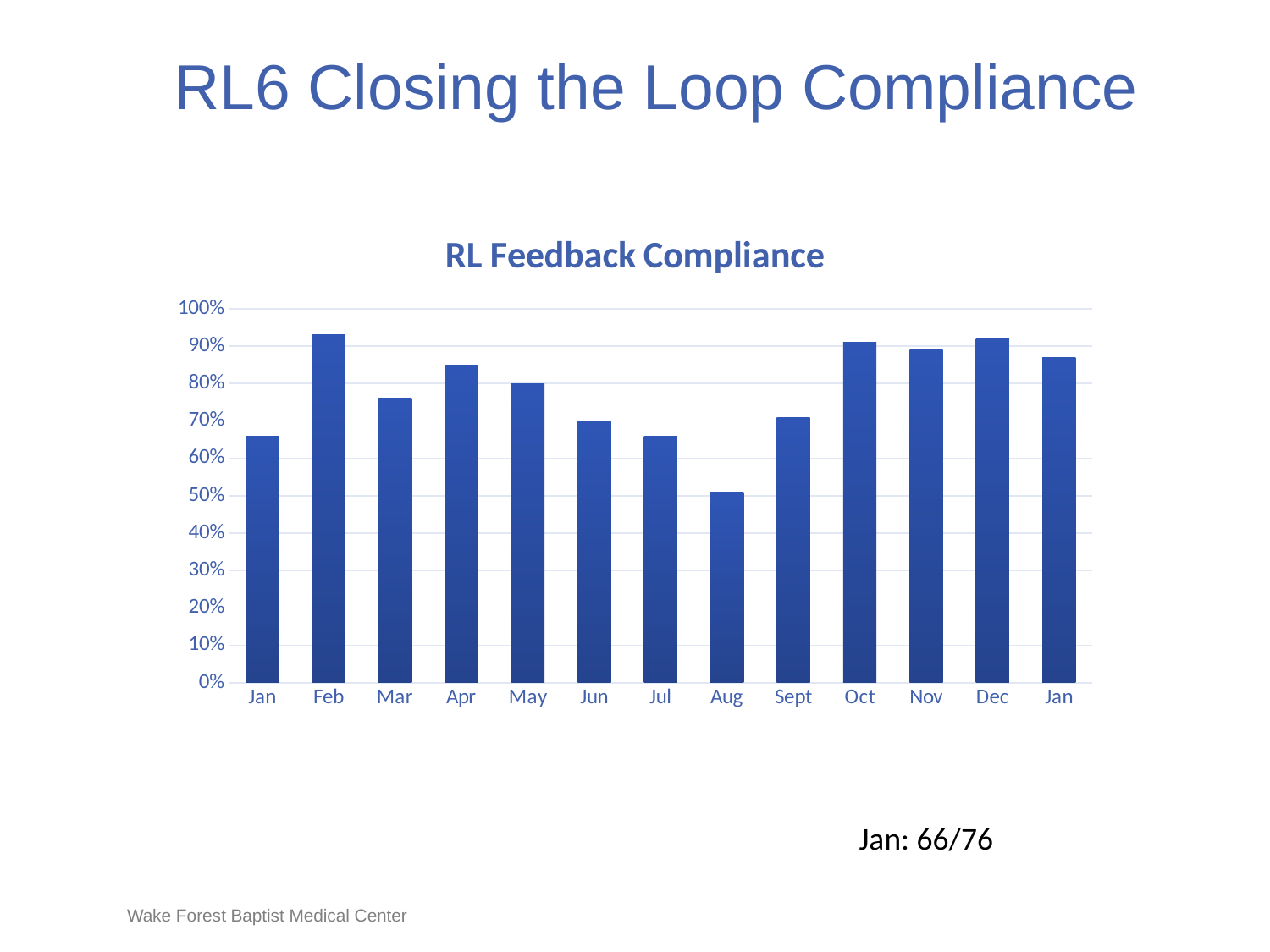
How many bars (months) are plotted in the RL Feedback Compliance chart? 13 Is the value for Feb greater or less than 90%? greater Is the value for Apr greater or less than 80%? greater Is the value for Jul greater or less than 70%? less Do the values rise or fall from May through Aug? fall Which month has the lowest RL Feedback Compliance? Aug What kind of chart is shown on the slide? bar chart Which is larger, the value for Oct or the value for Jul? Oct Which is larger, the value for Feb or the value for Aug? Feb What is the title of the chart? RL Feedback Compliance